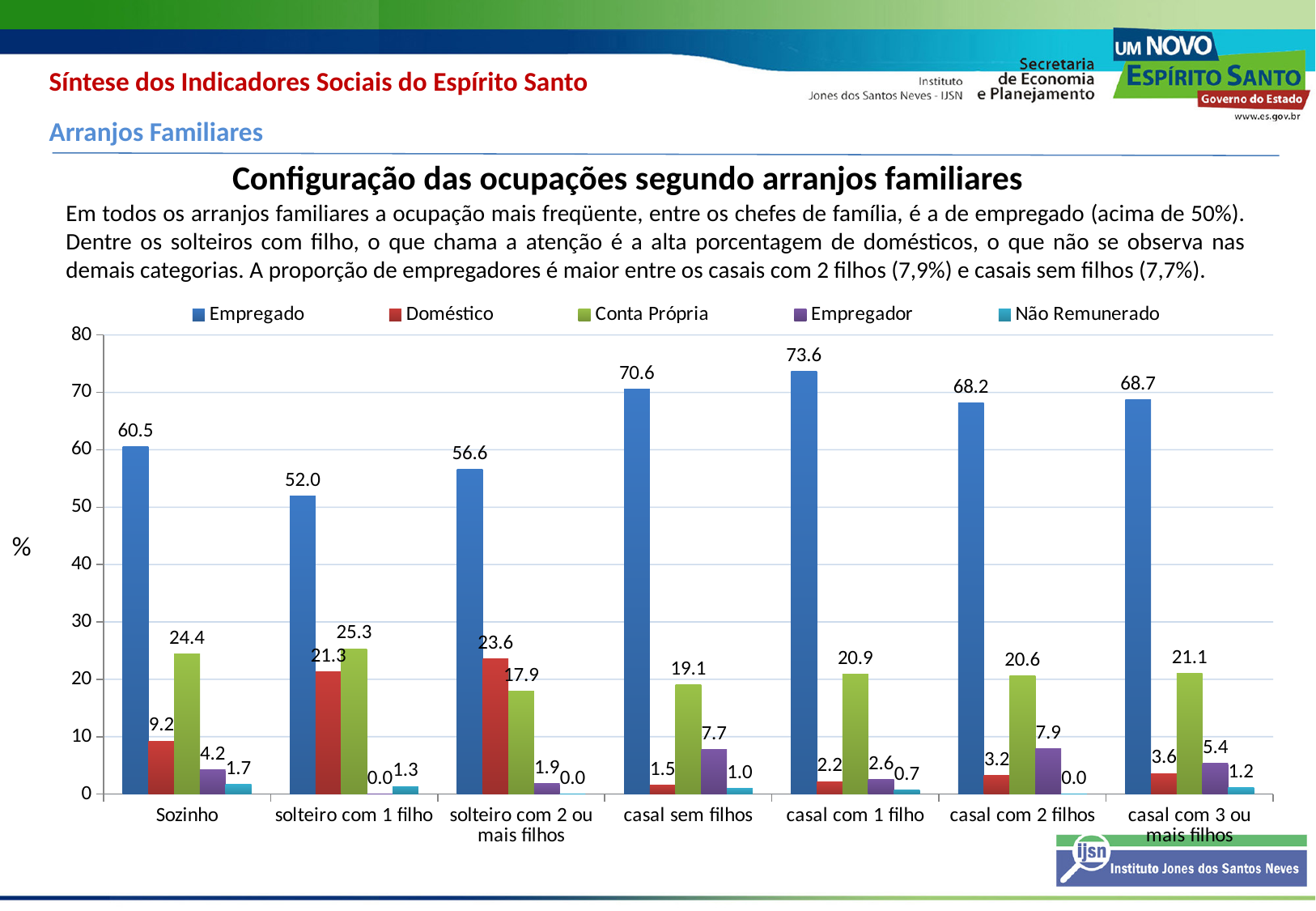
Which is larger, the Conta Própria value for Sozinho or for solteiro com 1 filho? solteiro com 1 filho Which family arrangement has the highest Empregado value? casal com 1 filho How many family arrangement categories are shown on the x axis? 7 How many series does the legend list? 5 What is the Doméstico value for solteiro com 2 ou mais filhos? 23.6 What is the difference between the Empregado values for casal sem filhos and Sozinho? 10.1 What kind of chart is shown on the slide? bar chart What is the Empregado value for casal com 1 filho? 73.6 What is the Não Remunerado value for Sozinho? 1.7 What is the Empregador value for casal com 2 filhos? 7.9 Which family arrangement has the lowest Empregado value? solteiro com 1 filho Is the Empregado value for solteiro com 2 ou mais filhos greater or less than 50? greater